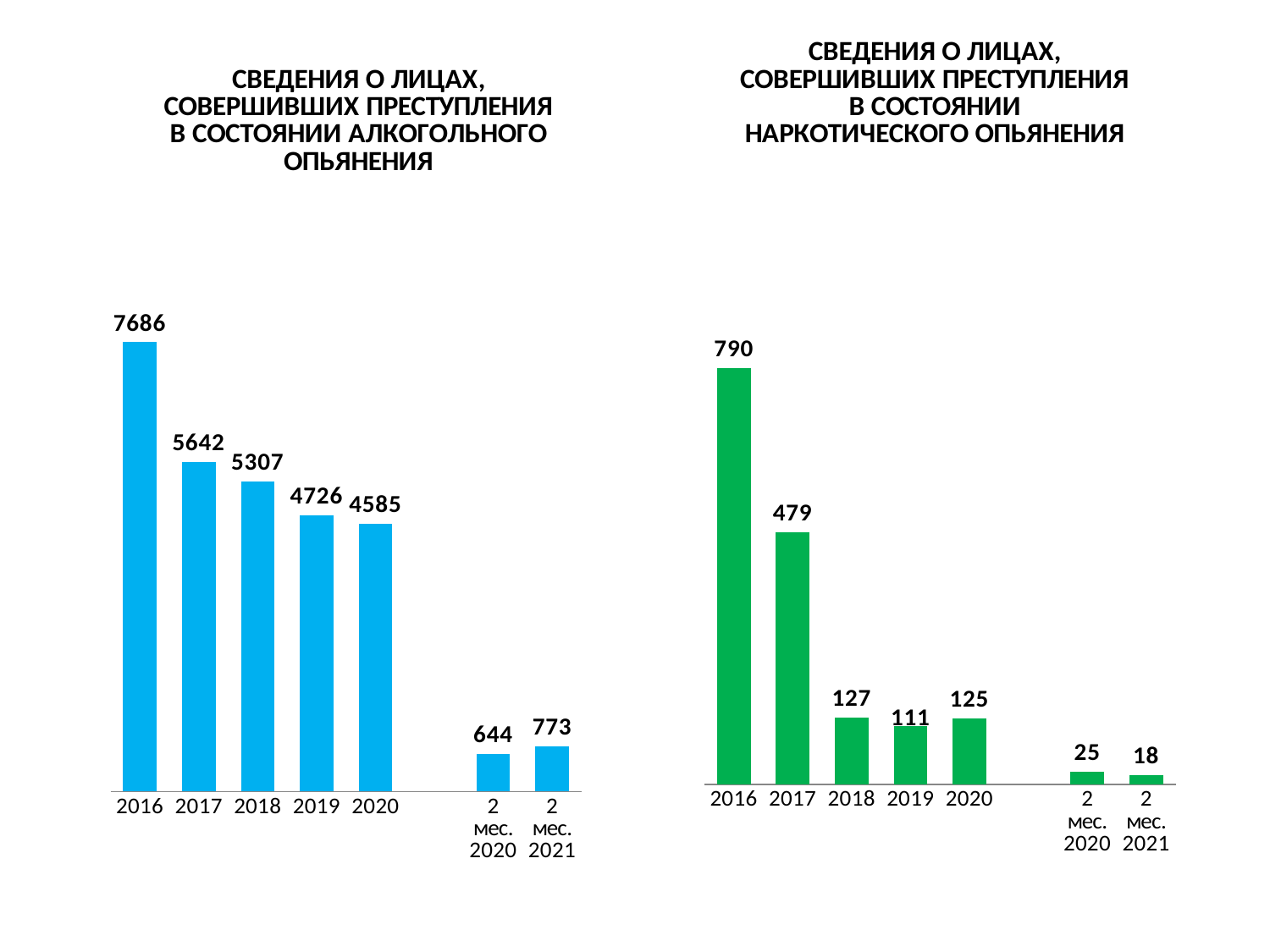
How many bars are plotted in the left chart (alcohol intoxication)? 7 In the left chart (alcohol intoxication), what is the value for 2 мес. 2021? 773 In the left chart (alcohol intoxication), which category has the lowest value? 2 мес. 2020 What colour are the bars in the right chart (narcotic intoxication)? green In the right chart (narcotic intoxication), what is the difference between the values for 2 мес. 2020 and 2 мес. 2021? 7 In the left chart (alcohol intoxication), what is the value for 2016? 7686 What type of chart is the right chart (narcotic intoxication)? bar chart In the right chart (narcotic intoxication), what is the value for 2019? 111 In the left chart (alcohol intoxication), what is the difference between the values for 2016 and 2017? 2044 In the left chart (alcohol intoxication), do the values rise or fall from 2016 to 2020? fall In the right chart (narcotic intoxication), which category has the highest value? 2016 In the right chart (narcotic intoxication), which is larger, the value for 2018 or the value for 2019? 2018